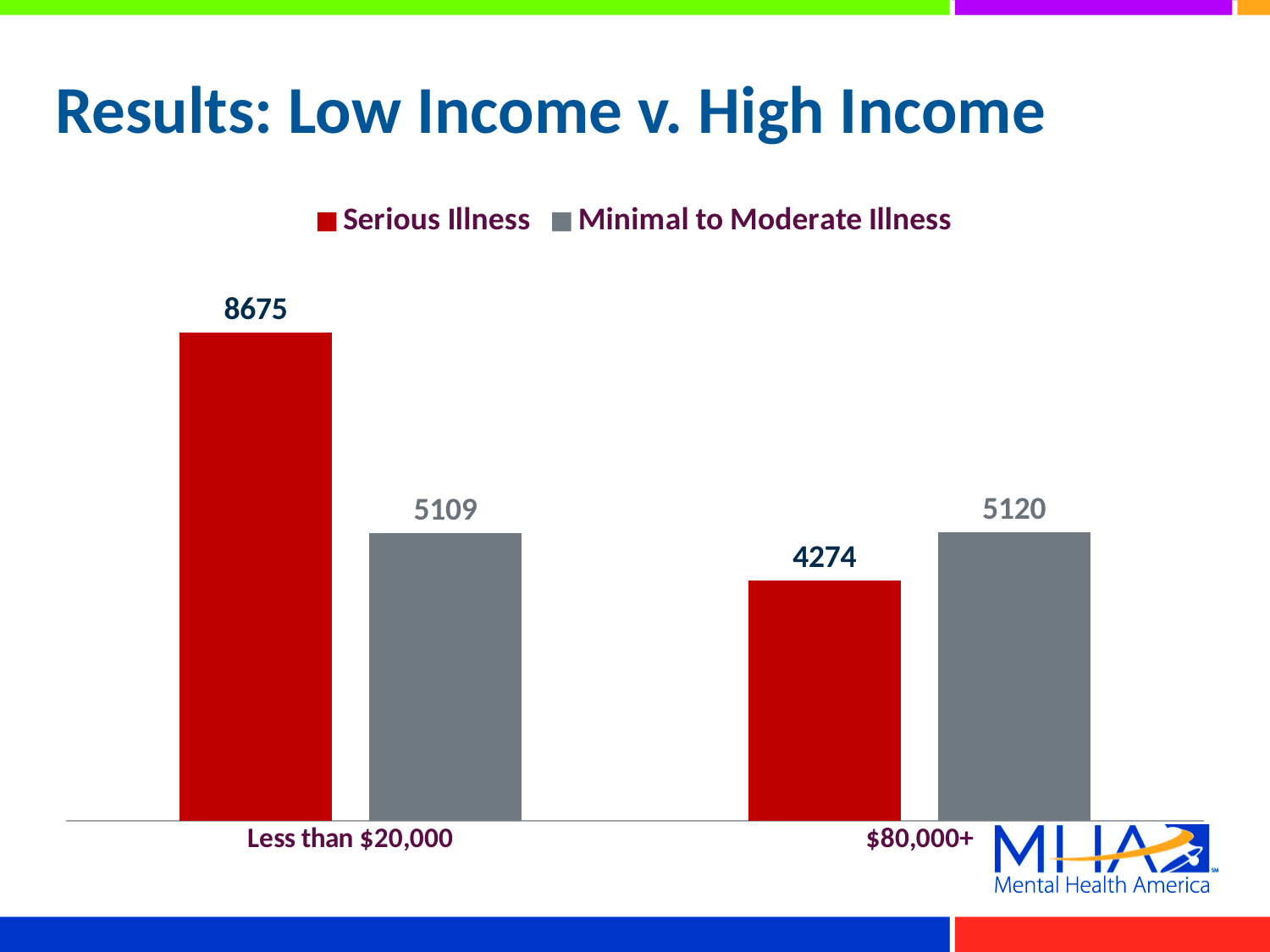
Which bar on the chart has the lowest value? Serious Illness, $80,000+ What is the value for Serious Illness in the $80,000+ category? 4274 What is the value for Serious Illness in the Less than $20,000 category? 8675 How many income categories are shown on the x axis? 2 What is the value for Minimal to Moderate Illness in the $80,000+ category? 5120 Which category has the highest Serious Illness value? Less than $20,000 What is the value for Minimal to Moderate Illness in the Less than $20,000 category? 5109 In the $80,000+ category, which is larger: Serious Illness or Minimal to Moderate Illness? Minimal to Moderate Illness How many series does the legend list? 2 What is the difference between the Serious Illness values for Less than $20,000 and $80,000+? 4401 What colour represents the Serious Illness series? Red What kind of chart is shown on the slide? Bar chart